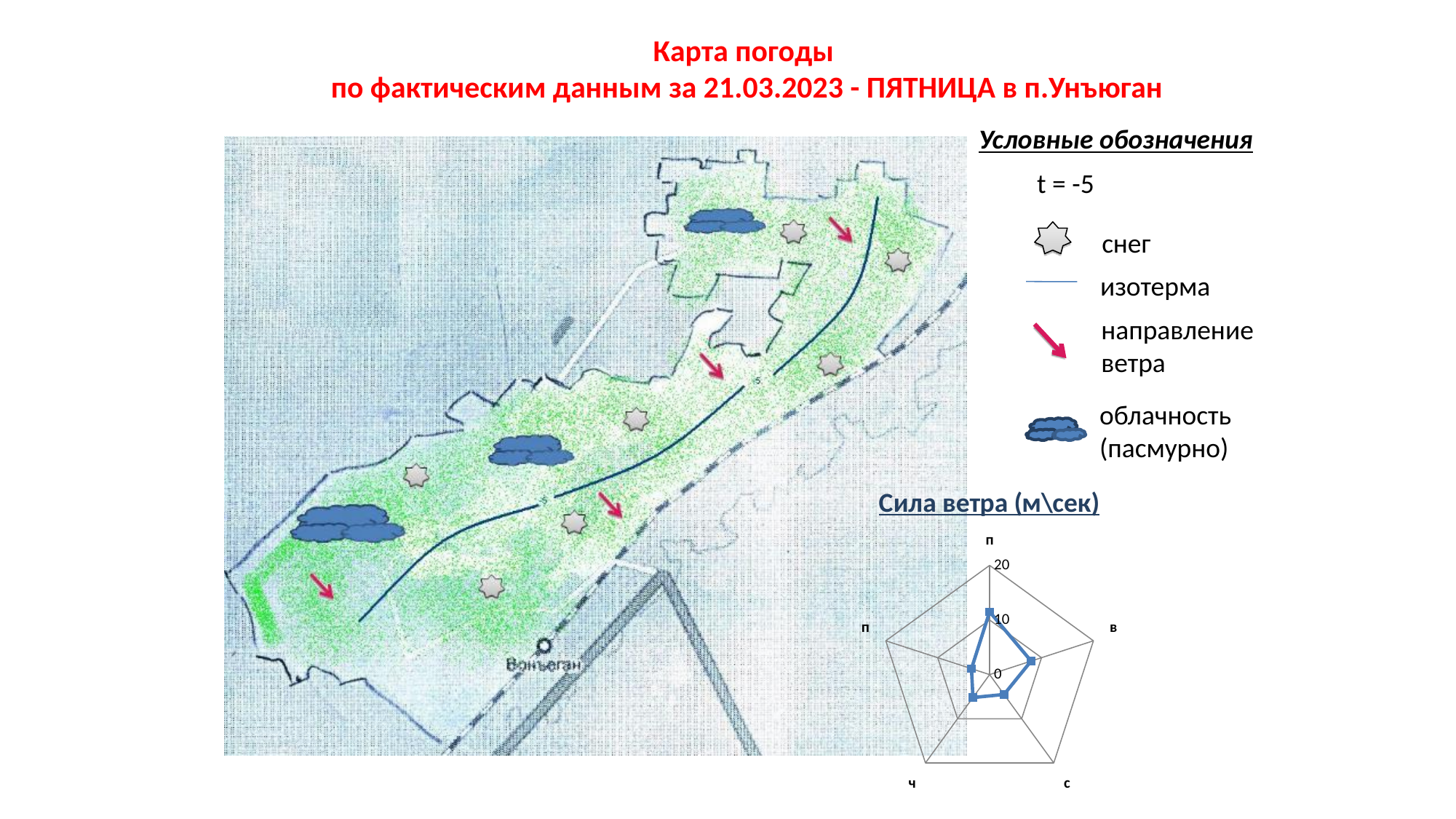
How many categories (axes) does the 'Сила ветра (м\сек)' radar chart have? 5 In the 'Сила ветра (м\сек)' chart, is the value for the top category 'п' greater or less than 20? less In the 'Сила ветра (м\сек)' chart, is the value for 'ч' greater or less than 10? less In the 'Сила ветра (м\сек)' chart, is the value for 'с' greater or less than 10? less In the 'Сила ветра (м\сек)' chart, which is larger: the value for 'в' or the value for 'с'? в What is the highest tick value shown on the axis of the 'Сила ветра (м\сек)' chart? 20 What is the title of the chart in the lower right of the slide? Сила ветра (м\сек) What kind of chart is the 'Сила ветра (м\сек)' chart? radar chart How many data series are plotted in the 'Сила ветра (м\сек)' chart? 1 In the 'Сила ветра (м\сек)' chart, which category has the highest value? п (top)